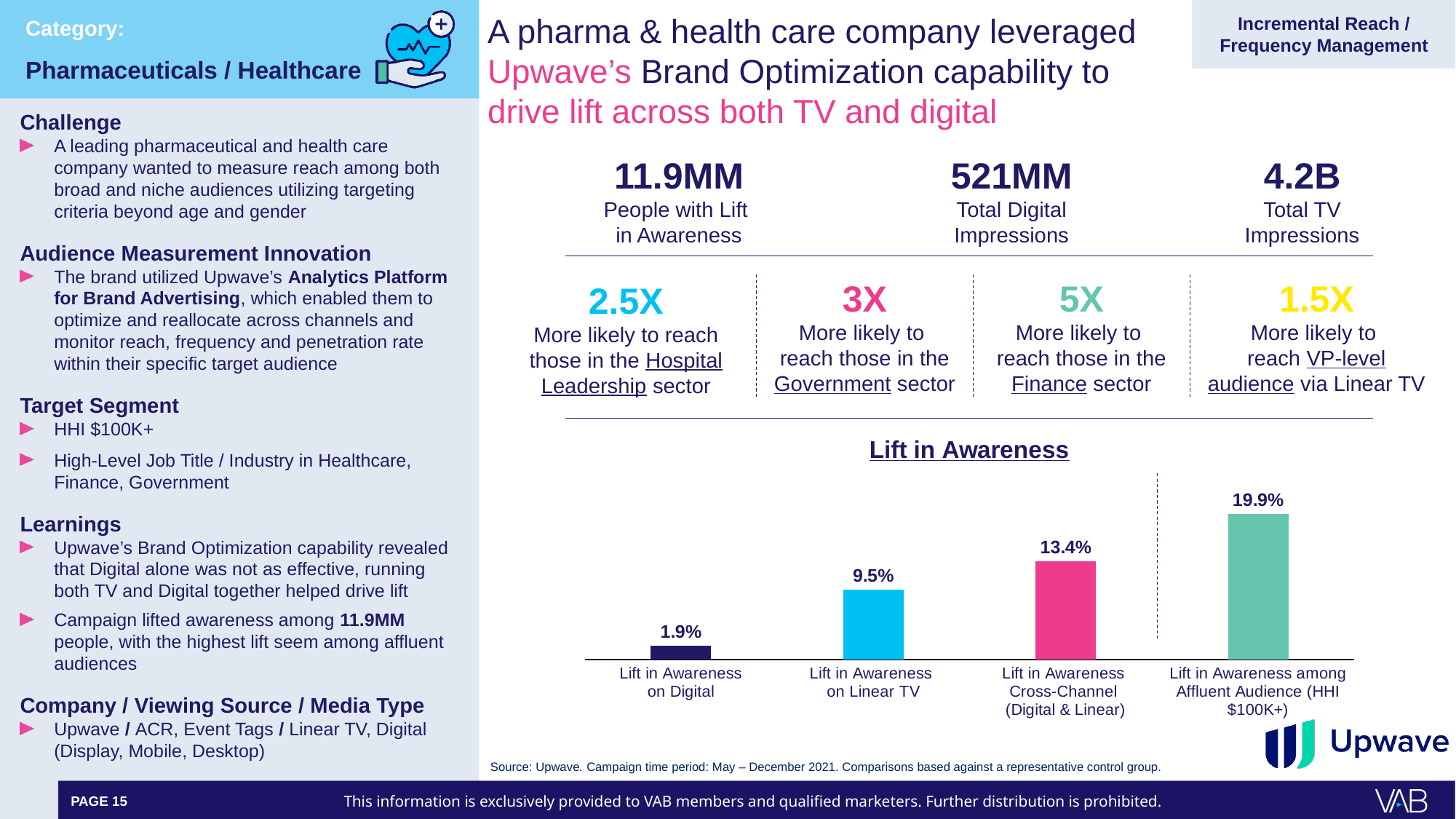
Which category has the highest lift in awareness? Lift in Awareness among Affluent Audience (HHI $100K+) What is the value for Lift in Awareness on Digital? 1.9% What is the value for Lift in Awareness Cross-Channel (Digital & Linear)? 13.4% What is the value for Lift in Awareness among Affluent Audience (HHI $100K+)? 19.9% What is the value for Lift in Awareness on Linear TV? 9.5% How many categories are shown in the Lift in Awareness chart? 4 What is the difference between the lift in awareness among the Affluent Audience and Cross-Channel? 6.5% Which is larger: lift in awareness on Linear TV or Cross-Channel (Digital & Linear)? Cross-Channel (Digital & Linear) What is the difference between the lift in awareness on Linear TV and on Digital? 7.6% What is the title of the chart on the slide? Lift in Awareness Which category has the lowest lift in awareness? Lift in Awareness on Digital What kind of chart is used to show Lift in Awareness? Bar chart